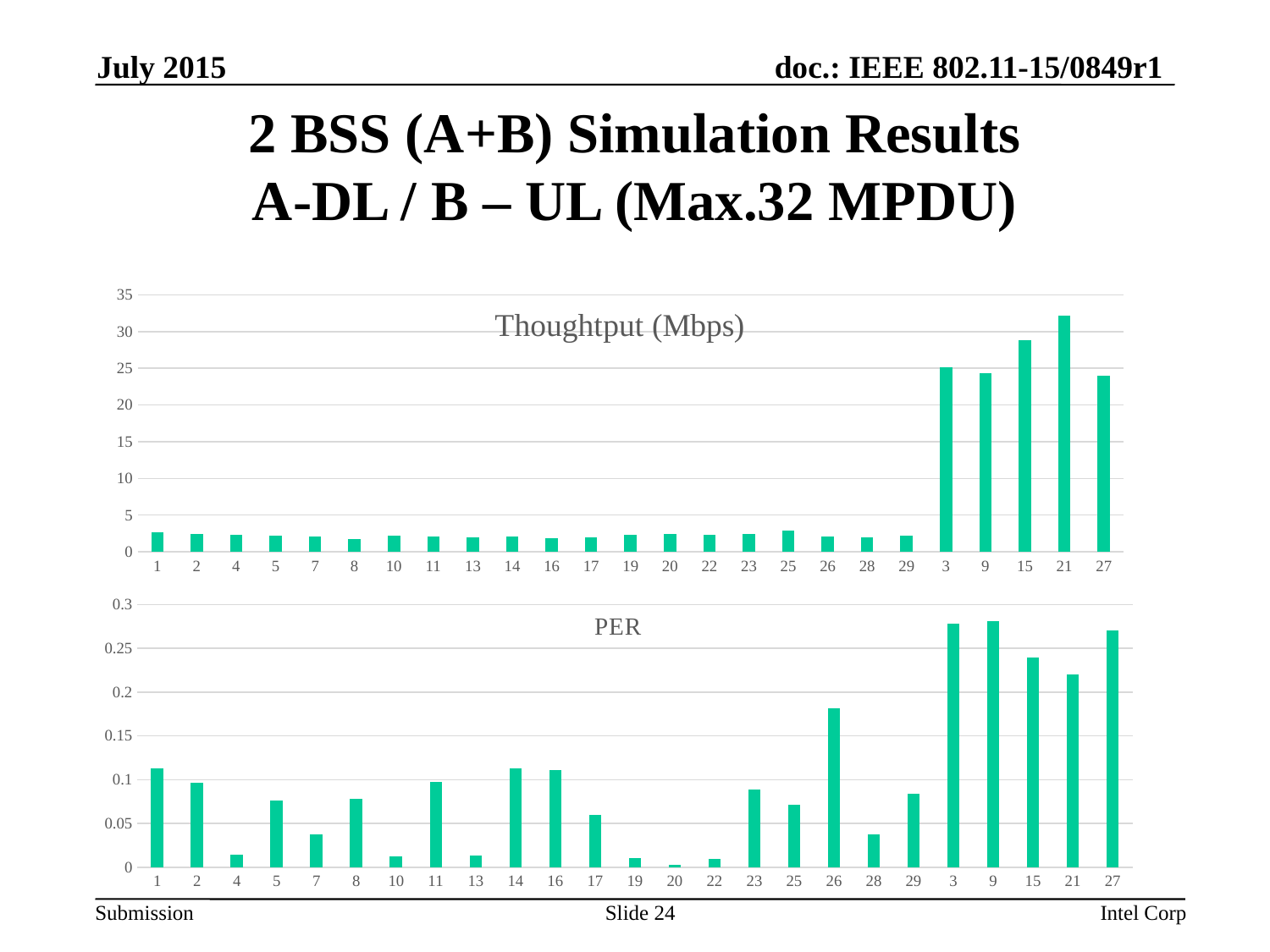
In the "Thoughtput (Mbps)" chart, is the value for category 21 greater or less than 30? greater In the "PER" chart, is the value for category 26 greater or less than 0.15? greater In the "PER" chart, which is larger, the value for category 26 or category 28? 26 How many categories are shown on the x axis of the "Thoughtput (Mbps)" chart? 25 In the "Thoughtput (Mbps)" chart, is the value for category 1 greater or less than 5? less In the "Thoughtput (Mbps)" chart, which category has the highest value? 21 In the "Thoughtput (Mbps)" chart, which is larger, the value for category 21 or category 27? 21 What is the title of the top chart on the slide? Thoughtput (Mbps) In the "PER" chart, which category has the lowest value? 20 What kind of chart is the top chart titled "Thoughtput (Mbps)"? bar chart